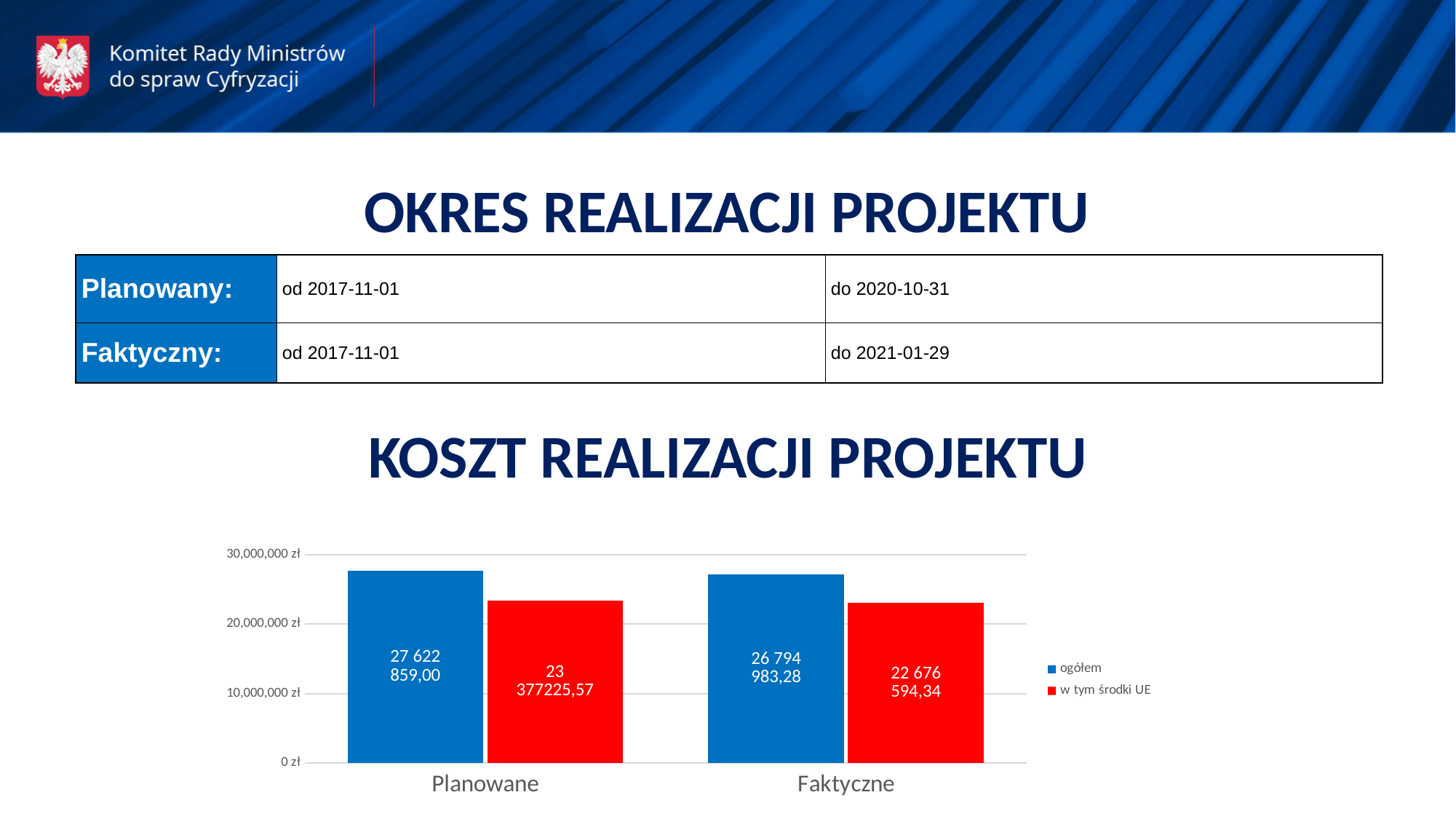
How many series does the legend of the cost chart list? 2 Which category has the higher ogółem value in the cost chart, Planowane or Faktyczne? Planowane What is the difference between the w tym środki UE values for Planowane and Faktyczne in the cost chart? 700 631,23 What is the value of w tym środki UE for Planowane in the cost chart? 23 377225,57 How many categories are shown on the x axis of the cost chart? 2 What is the value of w tym środki UE for Faktyczne in the cost chart? 22 676 594,34 What is the value of ogółem for Faktyczne in the cost chart? 26 794 983,28 Which colour represents the series w tym środki UE in the cost chart? red What kind of chart is shown under the title KOSZT REALIZACJI PROJEKTU? bar chart What is the value of ogółem for Planowane in the cost chart? 27 622 859,00 What is the difference between the ogółem values for Planowane and Faktyczne in the cost chart? 827 875,72 Is the ogółem value for Faktyczne in the cost chart greater or less than 20,000,000 zł? greater